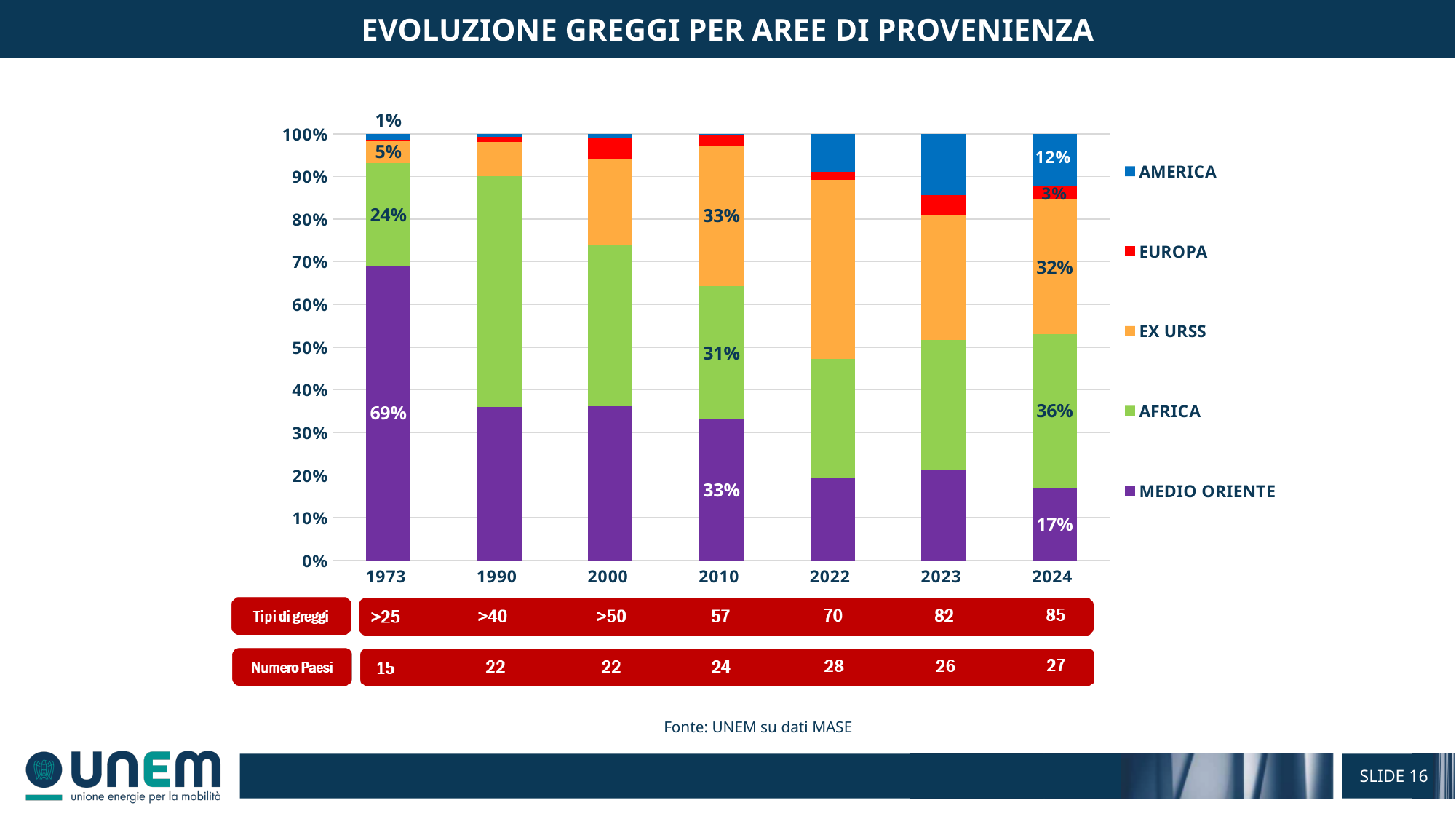
Which colour represents EX URSS in the legend? orange What is the difference between the MEDIO ORIENTE share in 1973 and in 2024? 52% How many years are shown on the x axis? 7 How many series does the legend list? 5 Is the MEDIO ORIENTE share in 2022 greater or less than 30%? less What kind of chart is shown on the slide? stacked bar chart What is the share of AFRICA in 2024? 36% What is the share of EX URSS in 2010? 33% Does the MEDIO ORIENTE share rise or fall from 1973 to 2024? fall What is the share of MEDIO ORIENTE in 1973? 69% Which is larger in 2024, the share of AFRICA or the share of EX URSS? AFRICA What is the share of AMERICA in 2024? 12%